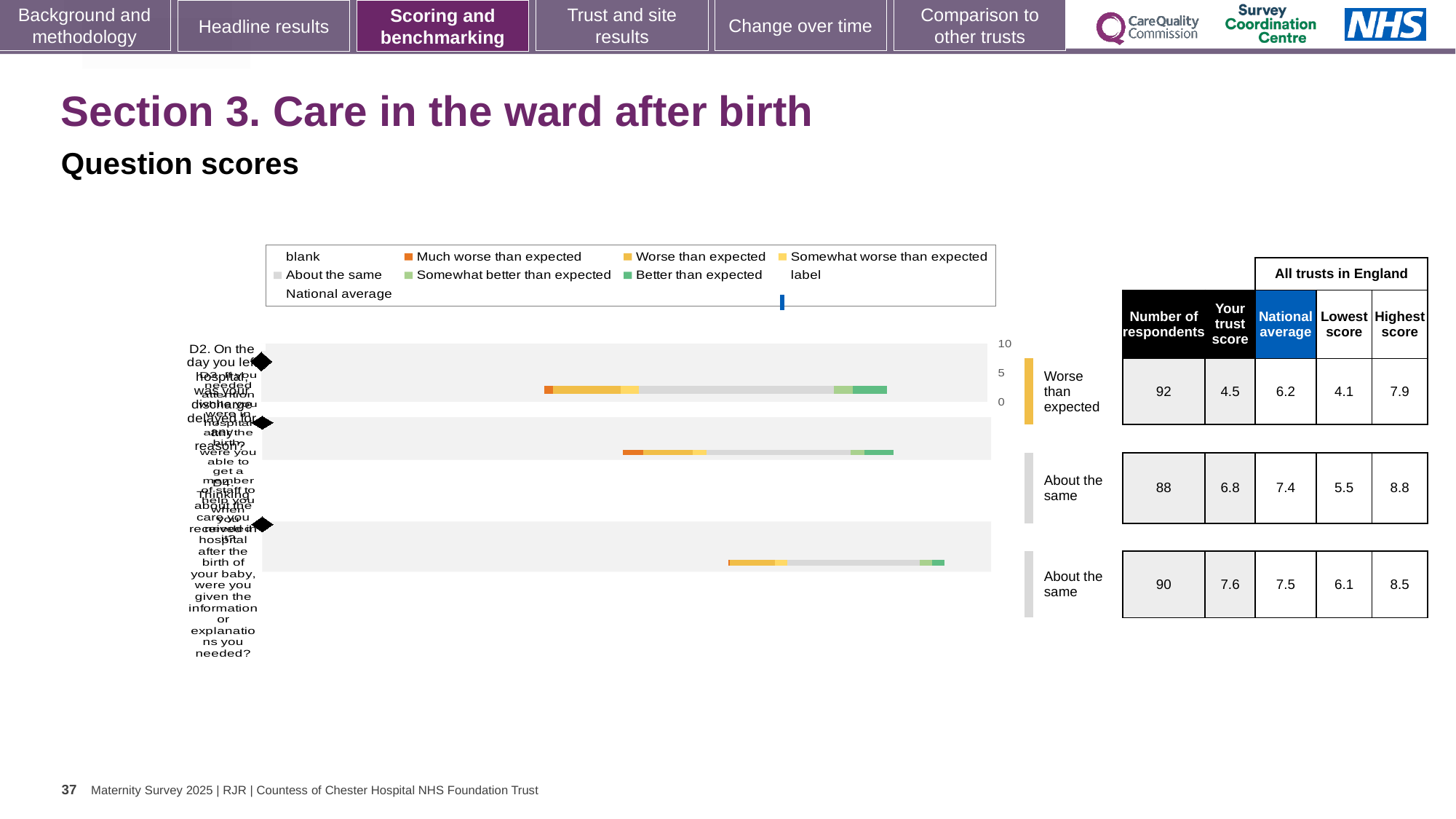
What colour does the legend use for 'Much worse than expected'? orange Which row has the larger 'Your trust score' in the table: the middle row or the bottom row? bottom row How many bars (question rows) are plotted in the chart? 3 Which row has the highest value in the 'Highest score' column of the table? middle row (8.8) What kind of chart is shown on the slide? bar chart For the top row, what is the difference between the National average (6.2) and Your trust score (4.5)? 1.7 What does the blue vertical line in the legend represent? National average According to the table beside the chart, how many respondents are there for the bottom row? 90 According to the table beside the chart, what is 'Your trust score' for the top row (rated 'Worse than expected')? 4.5